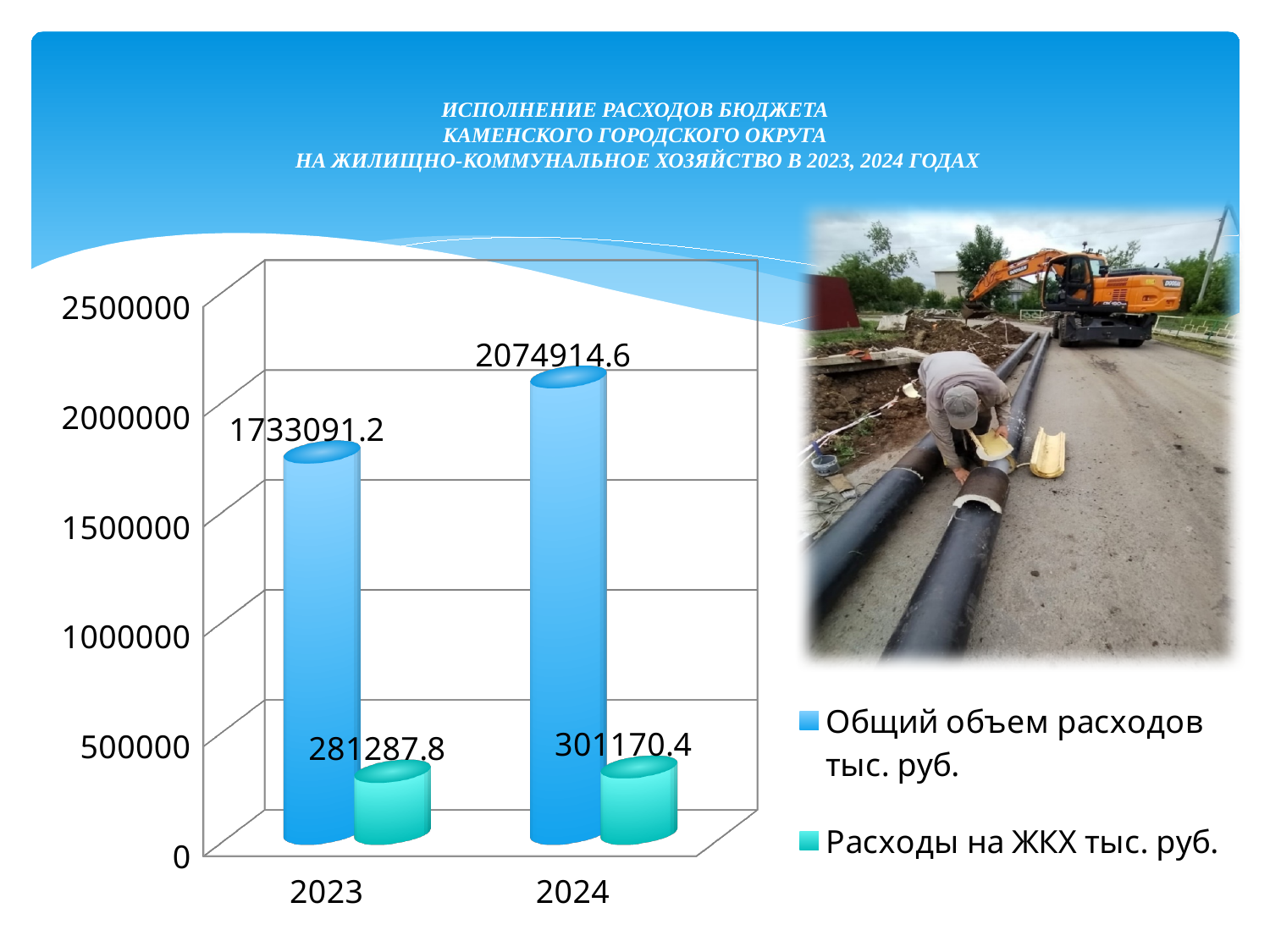
In which year is "Общий объем расходов тыс. руб." highest? 2024 What is the value of "Общий объем расходов тыс. руб." for 2023? 1733091.2 What is the value of "Расходы на ЖКХ тыс. руб." for 2024? 301170.4 Do the values of "Расходы на ЖКХ тыс. руб." rise or fall from 2023 to 2024? Rise What kind of chart is shown on the slide? Bar chart Which is larger: "Общий объем расходов тыс. руб." in 2023 or "Расходы на ЖКХ тыс. руб." in 2024? Общий объем расходов тыс. руб. in 2023 What is the value of "Расходы на ЖКХ тыс. руб." for 2023? 281287.8 In which year is "Расходы на ЖКХ тыс. руб." lowest? 2023 What is the value of "Общий объем расходов тыс. руб." for 2024? 2074914.6 How many series does the legend list? 2 What is the difference between "Расходы на ЖКХ тыс. руб." in 2024 and in 2023? 19882.6 By how much did "Общий объем расходов тыс. руб." increase from 2023 to 2024? 341823.4